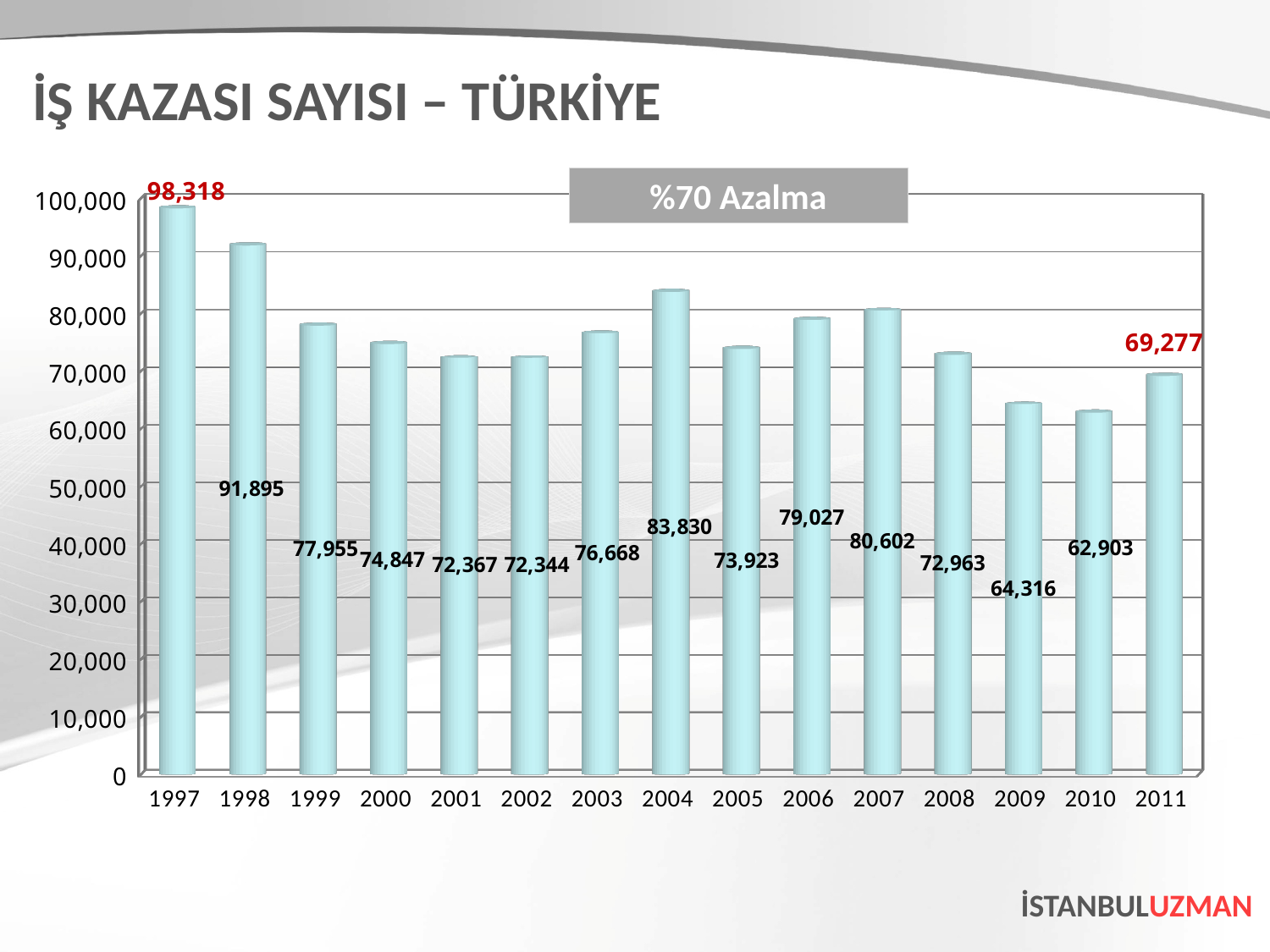
Which year has the highest value? 1997 What is the difference between the values for 2004 and 2003? 7,162 What is the value for 2011? 69,277 What is the value for 2004? 83,830 What is the value for 1997? 98,318 What type of chart is shown on the slide? bar chart Which year has the lowest value? 2010 Is the value for 2008 greater or less than 70,000? greater What is the title of the slide? İŞ KAZASI SAYISI – TÜRKİYE Which year has a larger value, 2006 or 2007? 2007 How many years are shown on the x axis? 15 What is the difference between the values for 1997 and 2011? 29,041